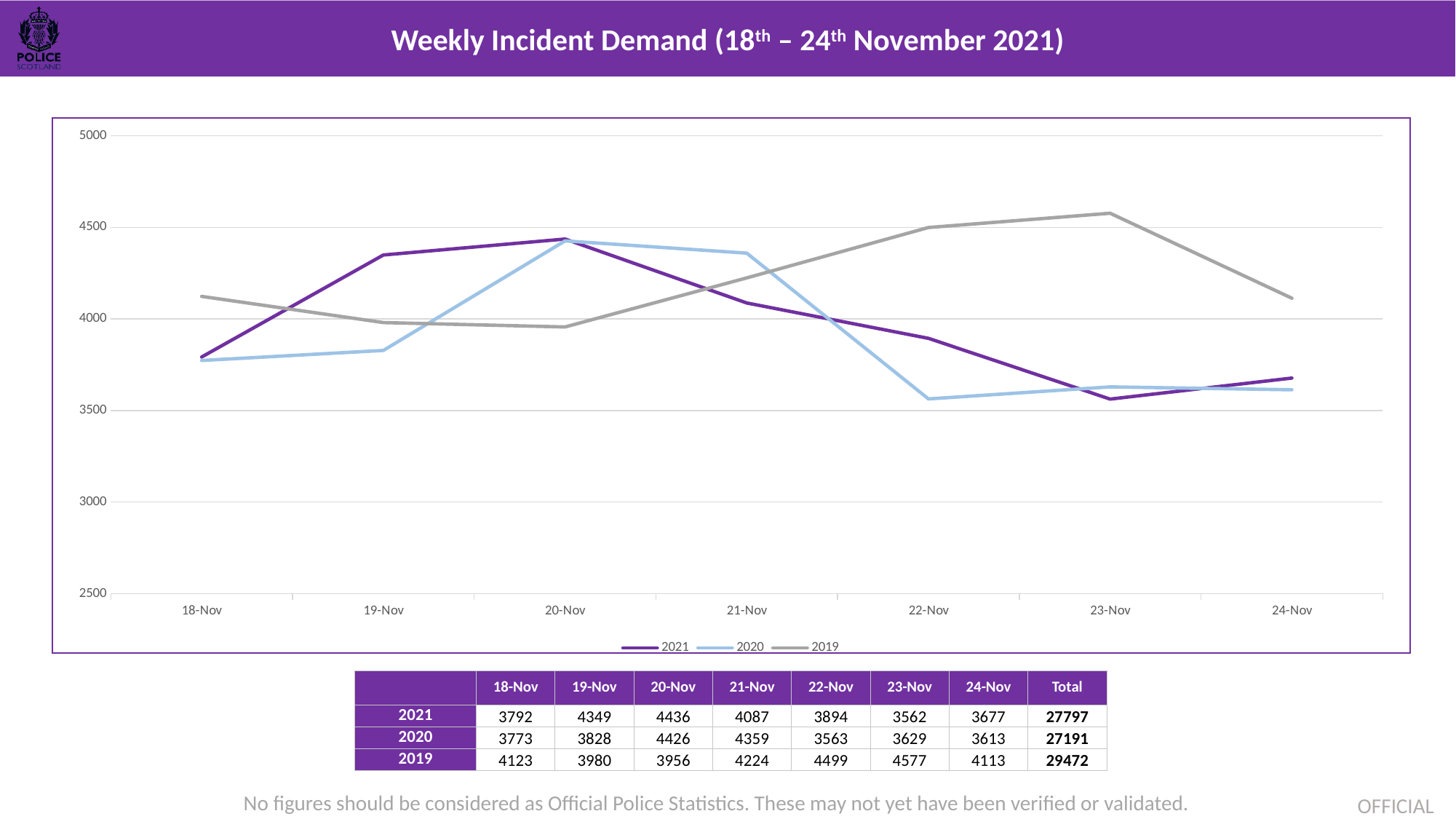
On 21-Nov, which series has the larger value, 2020 or 2021? 2020 What is the difference between the 2021 and 2020 values on 19-Nov? 521 How many series does the legend list? 3 Does the 2021 line rise or fall from 20-Nov to 23-Nov? fall What type of chart is shown on the slide? line chart What is the weekly total for 2019? 29472 What was the incident demand for 2020 on 22-Nov? 3563 How many dates are plotted along the x axis? 7 On which date was the 2021 value lowest? 23-Nov Is the 2019 value on 23-Nov greater or less than 4500? greater On which date was the 2019 value highest? 23-Nov What was the incident demand for 2021 on 20-Nov? 4436